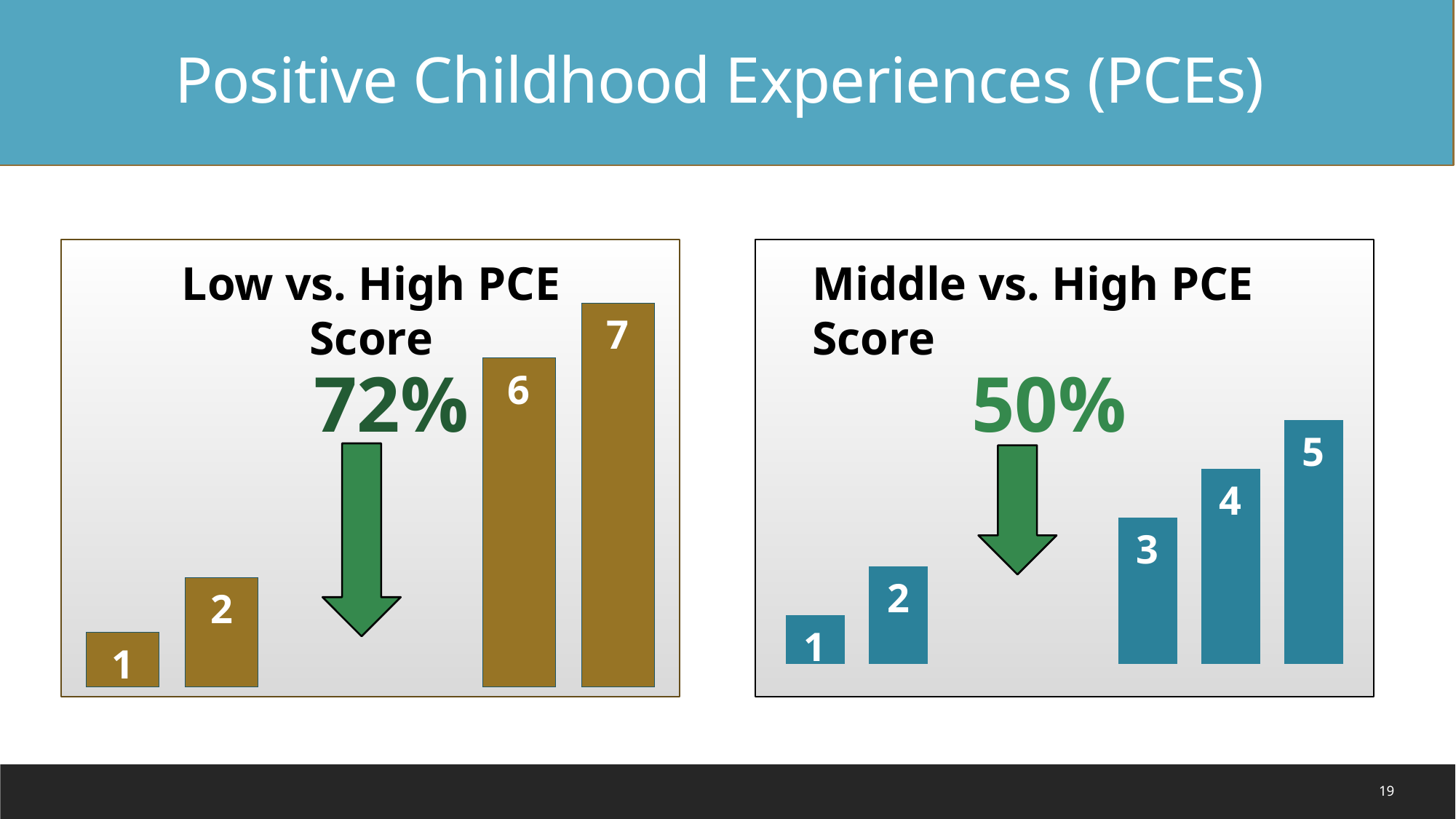
In the 'Low vs. High PCE Score' chart, which labeled bar is the shortest? 1 How many bars are shown in the 'Low vs. High PCE Score' chart? 4 In the 'Low vs. High PCE Score' chart, which labeled bar is the tallest? 7 What percentage is printed above the arrow in the 'Low vs. High PCE Score' chart? 72% Which percentage is larger, the one in the 'Low vs. High PCE Score' chart or the one in the 'Middle vs. High PCE Score' chart? Low vs. High PCE Score (72%) How many bars are shown in the 'Middle vs. High PCE Score' chart? 5 In the 'Middle vs. High PCE Score' chart, which labeled bar is the tallest? 5 Do the bar heights in the 'Middle vs. High PCE Score' chart rise or fall from left to right? rise What kind of chart is shown in the 'Low vs. High PCE Score' panel? bar chart In the 'Middle vs. High PCE Score' chart, is the bar labeled 4 taller or shorter than the bar labeled 3? taller What percentage is printed above the arrow in the 'Middle vs. High PCE Score' chart? 50% What colour are the bars in the 'Middle vs. High PCE Score' chart? blue